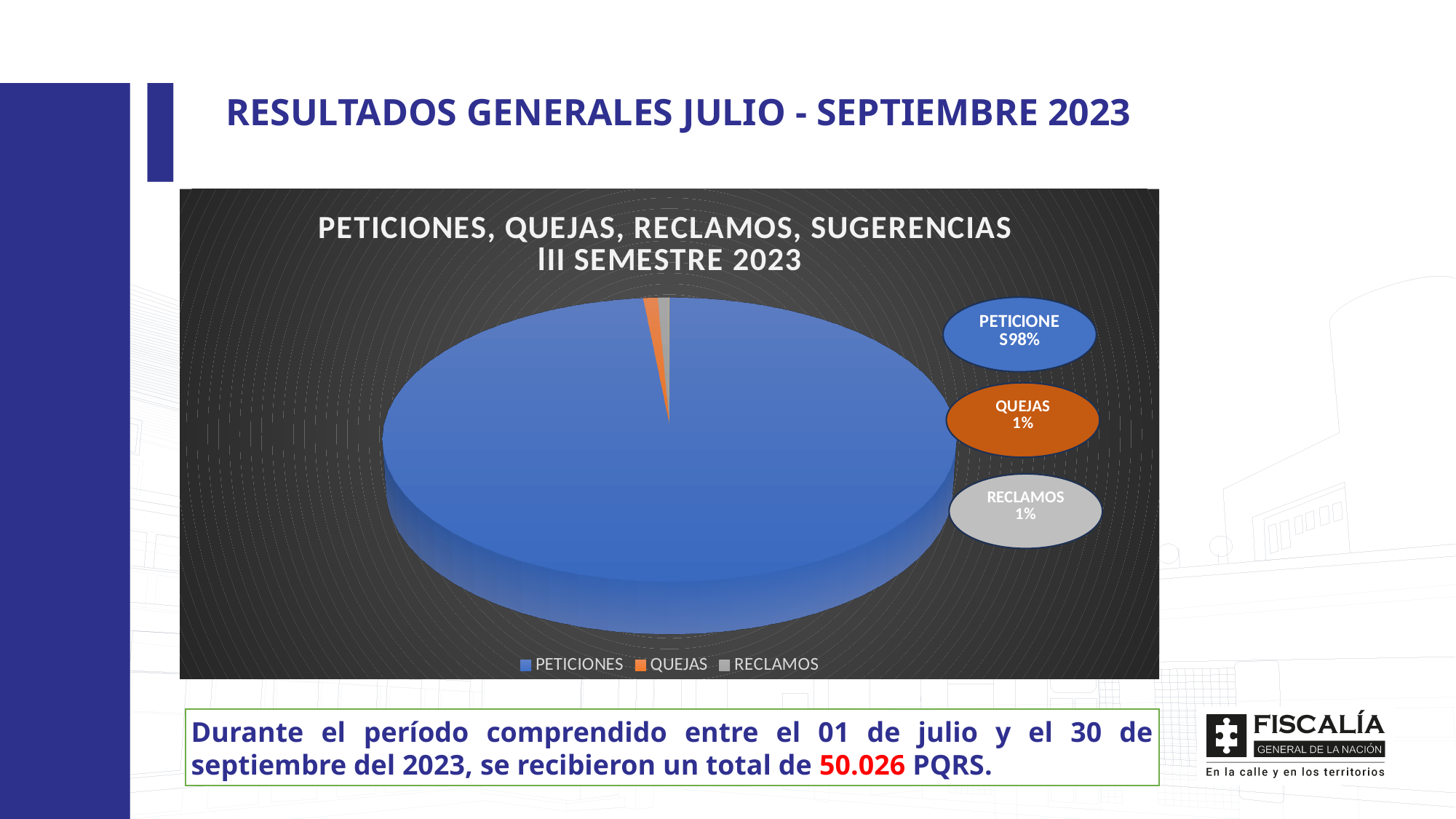
What is the difference in percentage points between the PETICIONES share and the RECLAMOS share? 97 How many entries does the legend list? 3 What share of the pie does QUEJAS represent? 1% What share of the pie does RECLAMOS represent? 1% How many slices does the pie chart have? 3 What kind of chart is shown on the slide? Pie chart What is the title of the chart? PETICIONES, QUEJAS, RECLAMOS, SUGERENCIAS III SEMESTRE 2023 Which category has the largest slice of the pie? PETICIONES What colour represents QUEJAS in the chart? Orange Which is larger, the share for PETICIONES or the share for QUEJAS? PETICIONES What share of the pie does PETICIONES represent? 98%